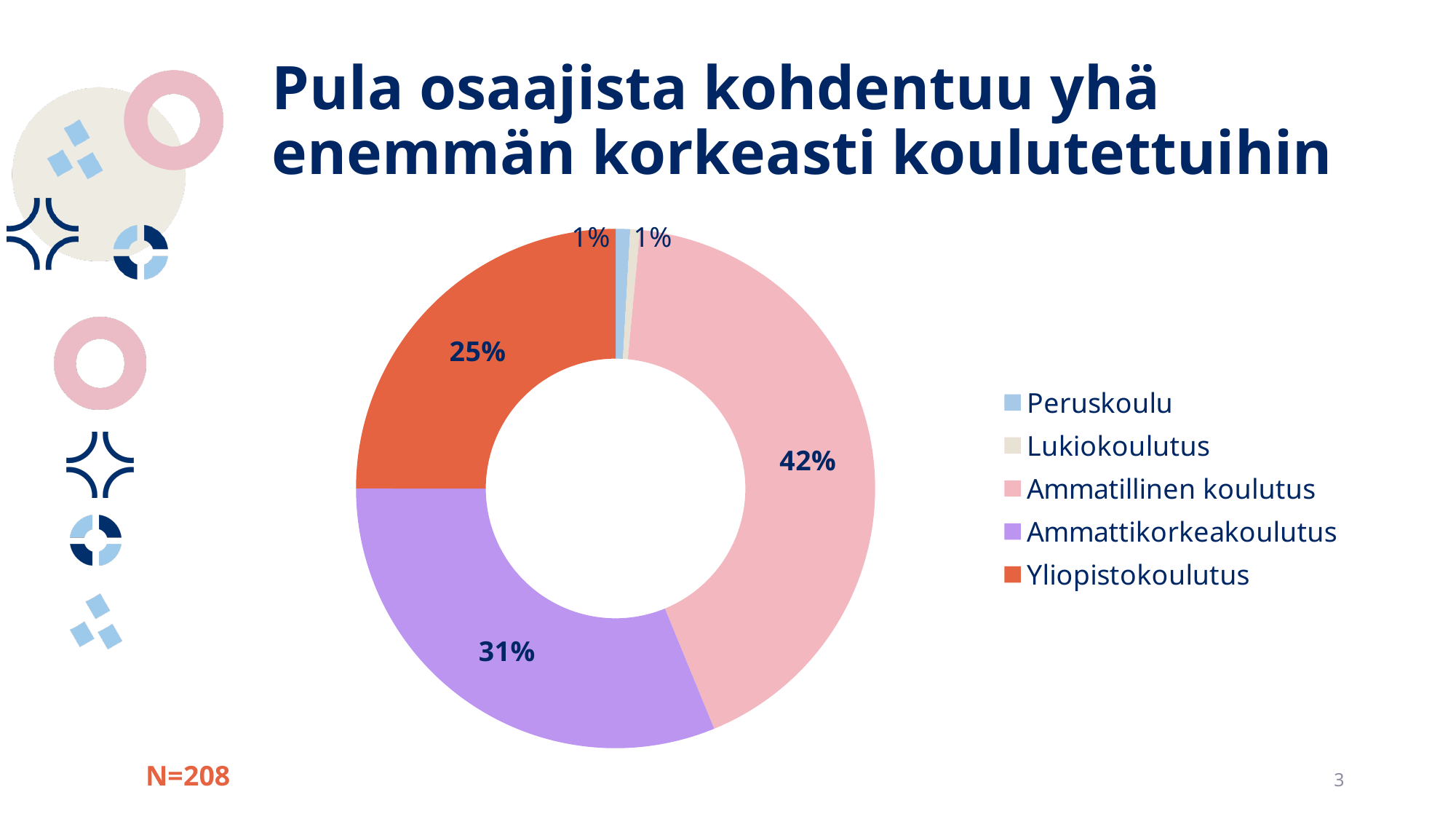
What sample size (N) is stated on the slide? N=208 What is the difference in percentage points between Ammattikorkeakoulutus and Yliopistokoulutus? 6 What kind of chart is shown on the slide? Doughnut (pie) chart How many categories does the legend list? 5 What share of the chart does Ammatillinen koulutus represent? 42% Which is larger, the share for Ammattikorkeakoulutus or the share for Yliopistokoulutus? Ammattikorkeakoulutus Which category has the largest share of the chart? Ammatillinen koulutus What is the difference in percentage points between Ammatillinen koulutus and Yliopistokoulutus? 17 What is the value shown for Ammattikorkeakoulutus? 31% What percentage is shown for Peruskoulu? 1% What colour is the Yliopistokoulutus slice? Orange-red What percentage is shown for Yliopistokoulutus? 25%